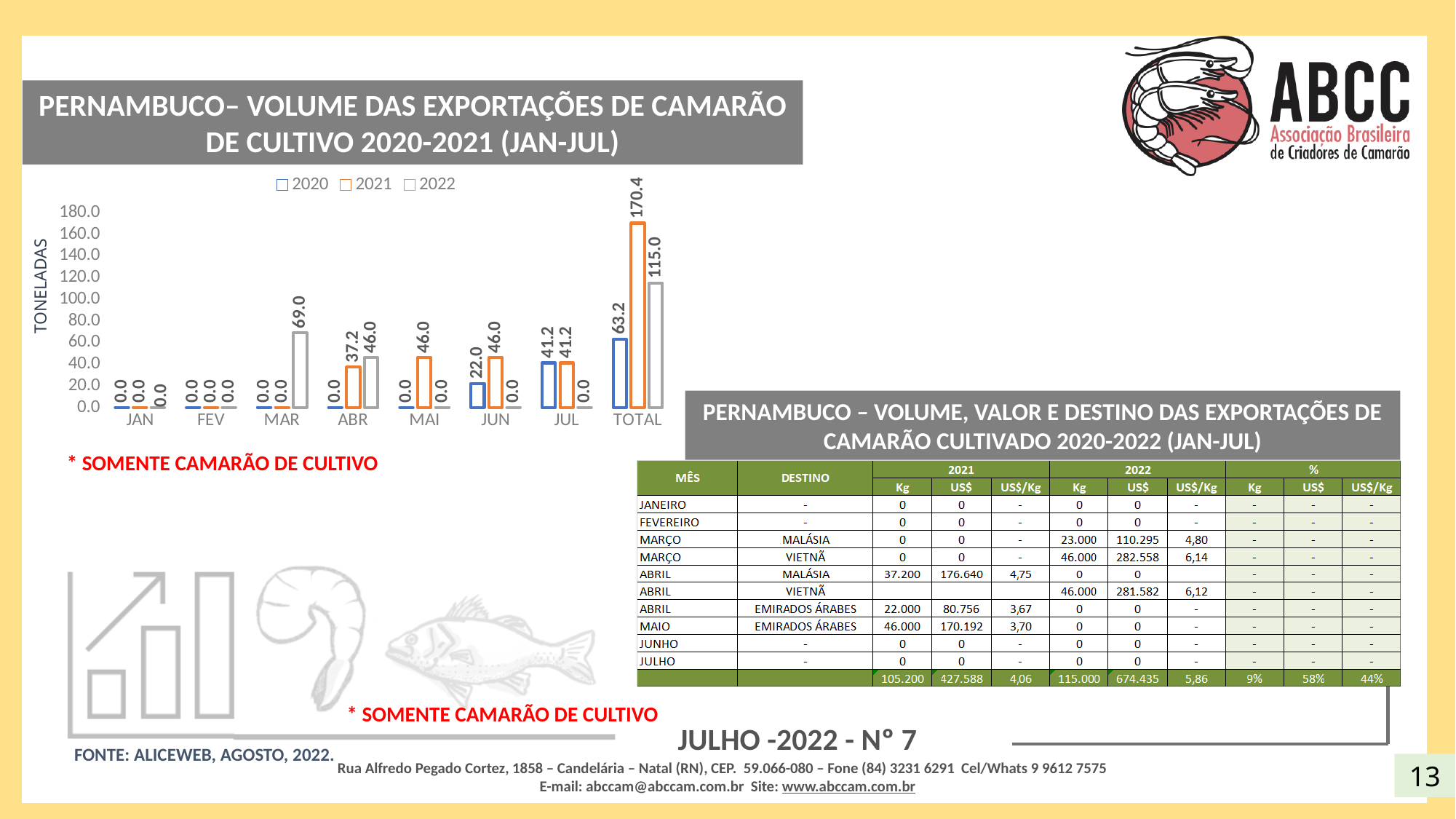
What type of chart is shown on the slide? bar chart What is the difference between the 2021 and 2022 TOTAL values in the chart? 55.4 Which is larger in the chart: the 2021 value for ABR or the 2022 value for ABR? 2022 What is the y-axis label of the chart? TONELADAS What is the 2021 value for ABR in the chart? 37.2 What is the 2020 value for JUL in the chart? 41.2 How many categories are shown on the x axis of the chart? 8 What is the 2022 value for MAR in the chart? 69.0 Which series has the highest TOTAL value in the chart? 2021 What is the TOTAL value for the 2021 series in the chart? 170.4 What is the 2020 value for JUN in the chart? 22.0 How many series does the chart legend list? 3